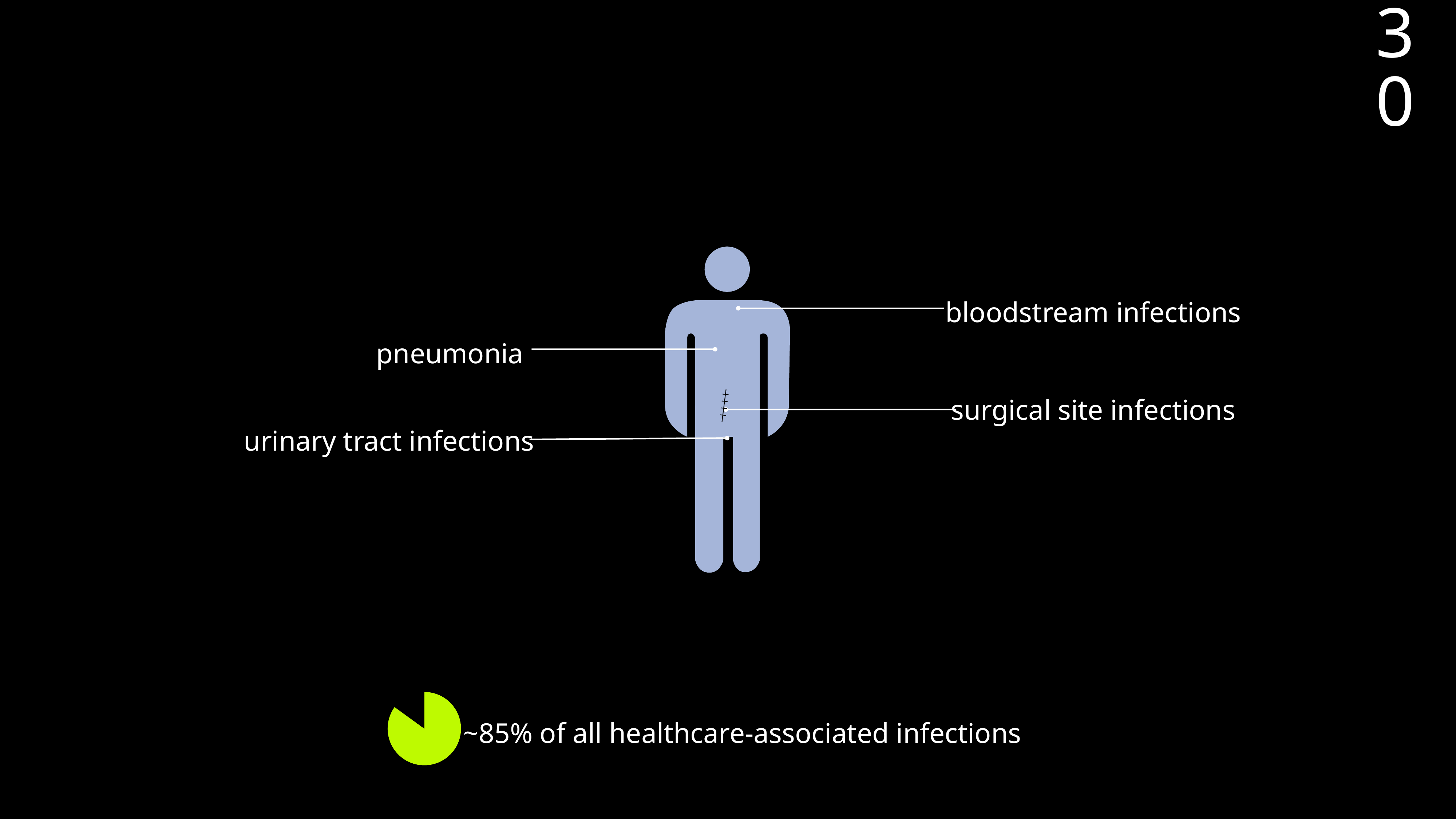
Is the filled green slice of the pie chart greater or less than 50% of the pie? greater What colour is the filled slice of the pie chart? green What kind of chart is shown at the bottom left of the slide? pie chart What text label is printed next to the pie chart? ~85% of all healthcare-associated infections